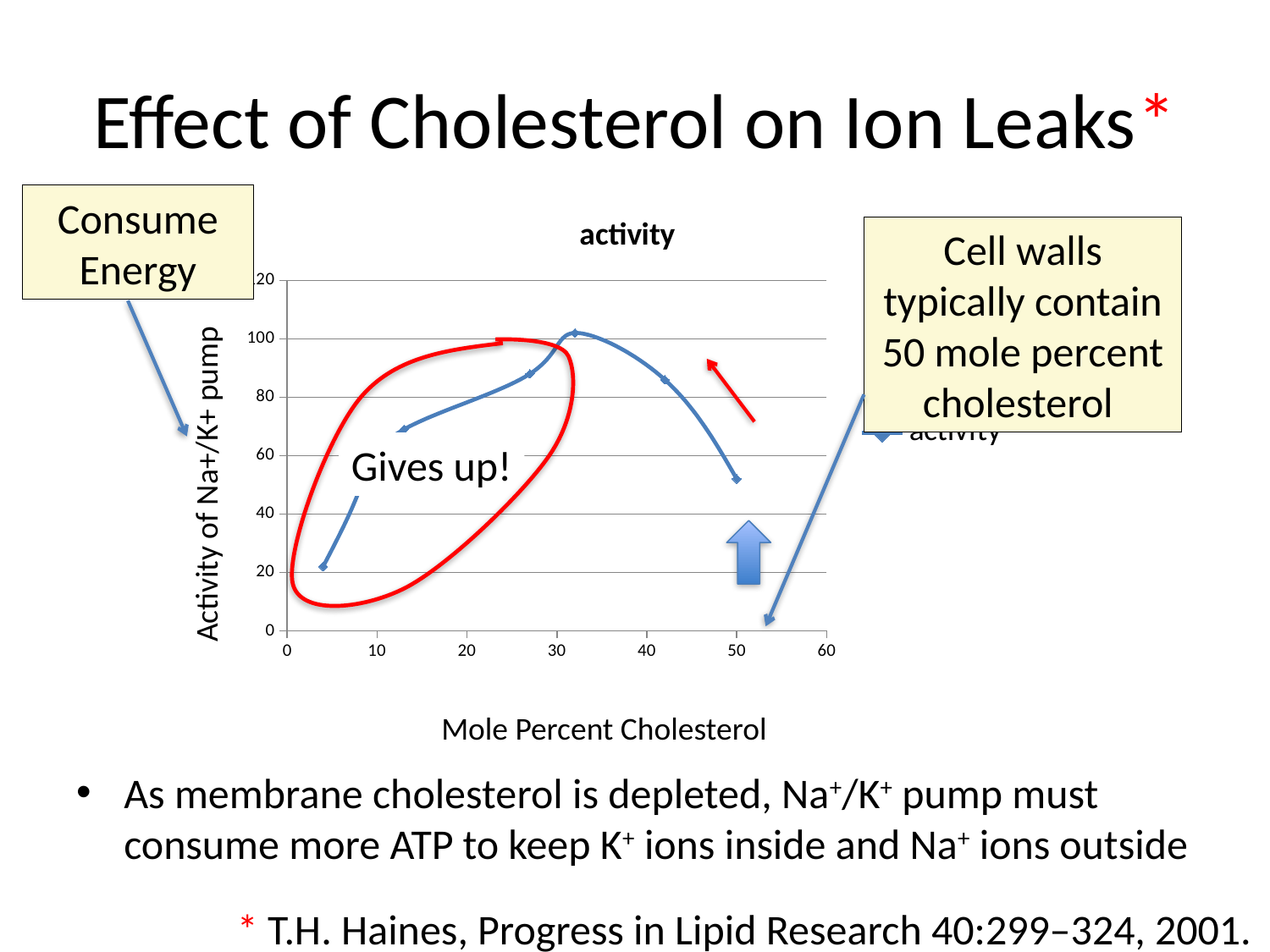
Which is larger: the value of the leftmost data point or the value of the rightmost data point? the rightmost data point Is the value of the highest data point on the chart greater or less than 80? greater Is the value of the rightmost data point (at about 50 mole percent cholesterol) greater or less than 60? less What is the highest value shown on the y axis of the chart? 120 How does the activity change as mole percent cholesterol increases from 0 to 60? rises to a peak around 30 then falls Is the value of the data point at about 40 mole percent cholesterol greater or less than 60? greater What is the title of the chart? activity What is the label of the x axis of the chart? Mole Percent Cholesterol What kind of chart is shown on the slide? line chart